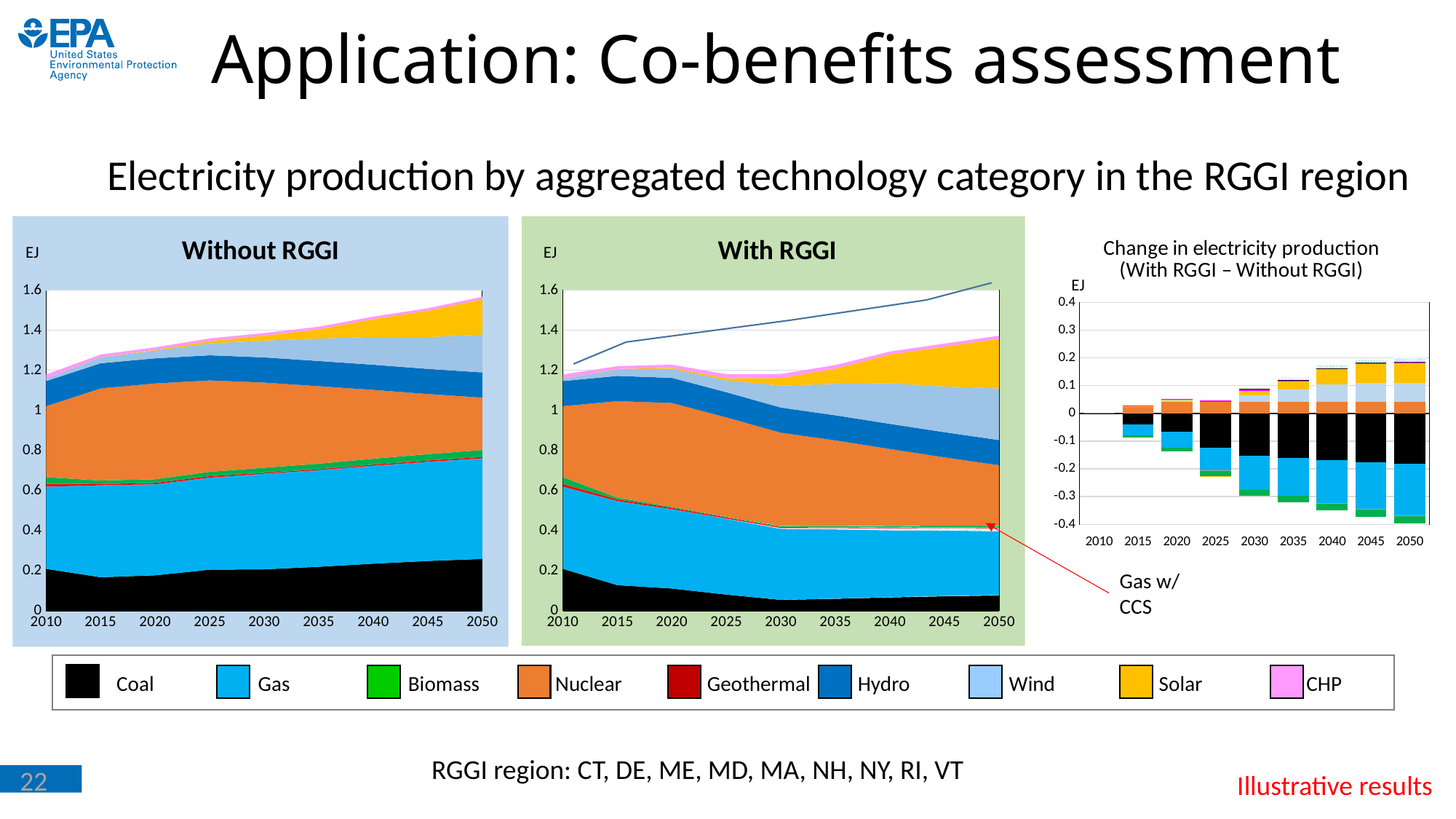
How many technology categories does the shared legend list? 9 In the "Without RGGI" chart, is the total electricity production in 2010 greater or less than 1.0 EJ? greater How many years are labeled on the x axis of the "Without RGGI" chart? 9 In the "Without RGGI" chart, does total electricity production rise or fall from 2010 to 2050? rise What kind of chart is the "Change in electricity production (With RGGI – Without RGGI)" chart? bar chart What unit is shown on the y axis of the charts? EJ In the "With RGGI" chart, does the Coal layer rise or fall from 2010 to 2050? fall What kind of chart is the "Without RGGI" chart? area chart In the "Change in electricity production" chart, is the bottom of the 2050 bar greater or less than -0.3? less In the "With RGGI" chart, is the total electricity production in 2050 greater or less than 1.2 EJ? greater In the "With RGGI" chart, which category does the red arrow point to? Gas w/ CCS